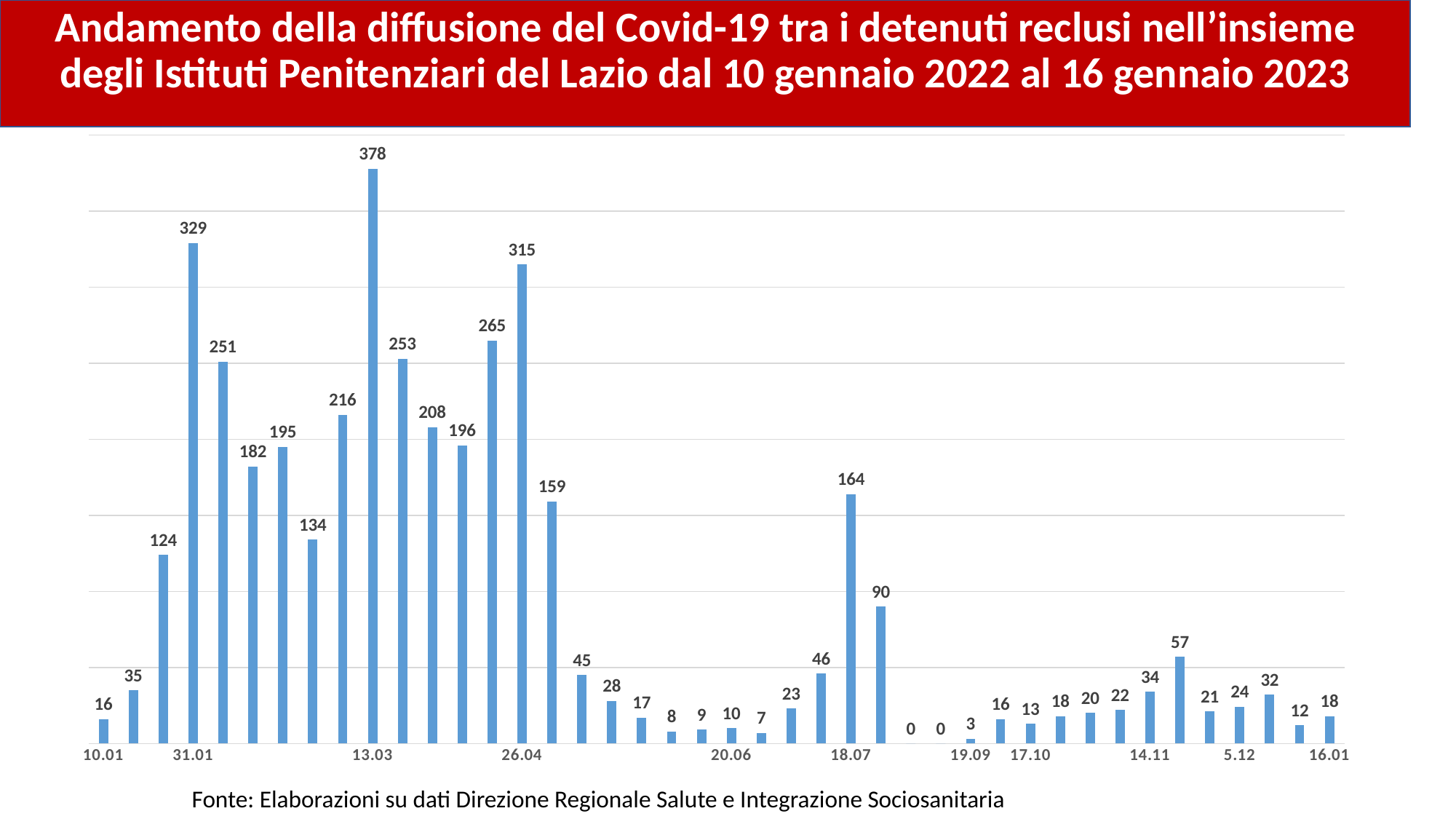
Which date has the highest value in the chart? 13.03 What is the lowest value shown on any bar in the chart? 0 What value is shown for 18.07? 164 What value is shown for 10.01? 16 What is the difference between the values for 13.03 and 31.01? 49 What value is shown for 16.01? 18 What is the difference between the values for 26.04 and 18.07? 151 Do the values rise or fall between 26.04 and 20.06? Fall Which has the larger value, 31.01 or 26.04? 31.01 What value is shown for 13.03? 378 What kind of chart is shown on the slide? Bar chart What value is shown for 31.01? 329